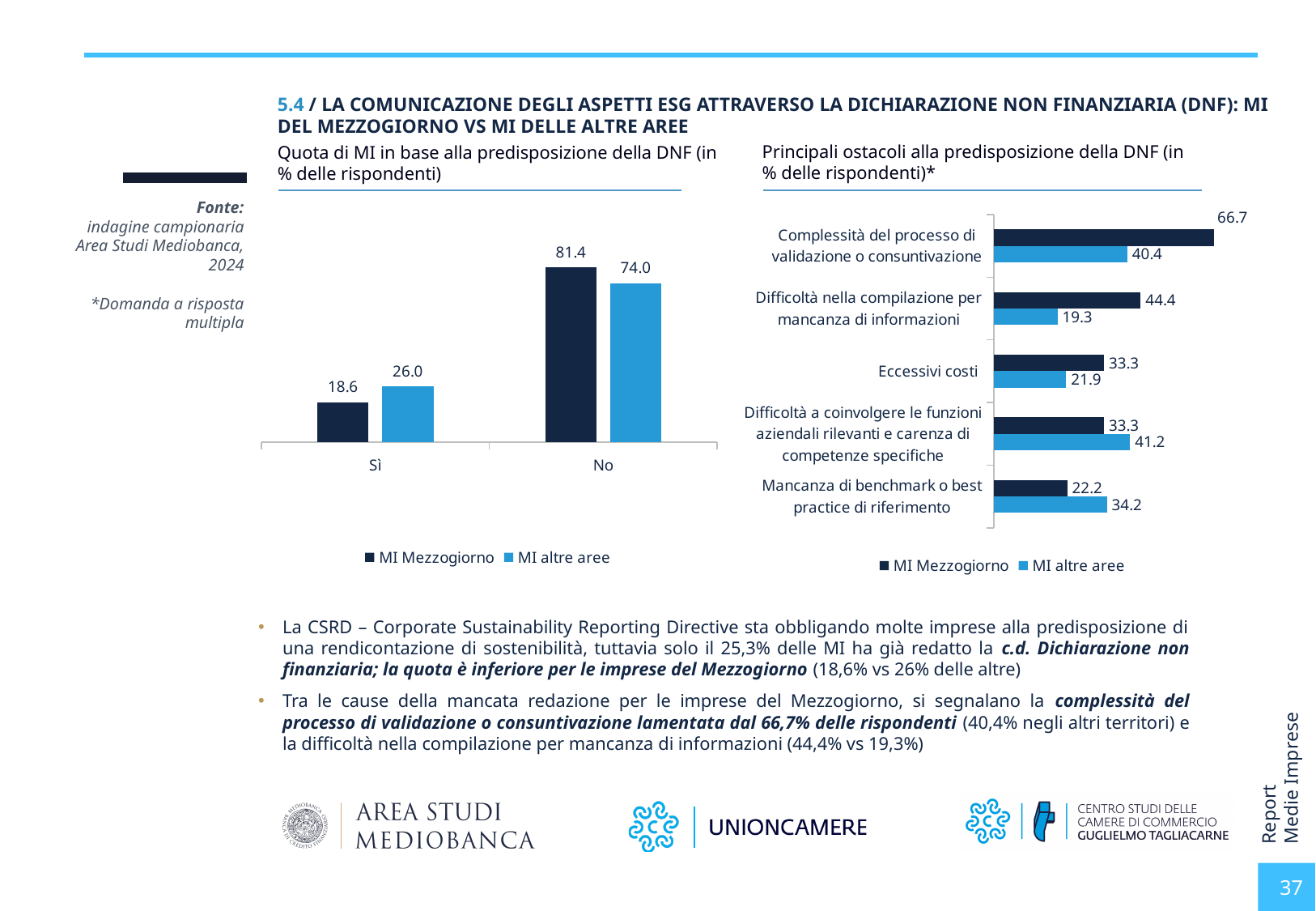
In the left chart (Quota di MI in base alla predisposizione della DNF), what is the value for MI altre aree in the 'No' category? 74.0 In the right chart (Principali ostacoli alla predisposizione della DNF), what is the value for MI Mezzogiorno for 'Complessità del processo di validazione o consuntivazione'? 66.7 In the right chart (Principali ostacoli alla predisposizione della DNF), which obstacle has the highest value for MI Mezzogiorno? Complessità del processo di validazione o consuntivazione In the right chart (Principali ostacoli alla predisposizione della DNF), which obstacle has the lowest value for MI altre aree? Difficoltà nella compilazione per mancanza di informazioni In the left chart (Quota di MI in base alla predisposizione della DNF), what is the value for MI Mezzogiorno in the 'Sì' category? 18.6 In the left chart (Quota di MI in base alla predisposizione della DNF), how many series does the legend list? 2 In the left chart (Quota di MI in base alla predisposizione della DNF), what kind of chart is shown? Bar chart In the right chart (Principali ostacoli alla predisposizione della DNF), for 'Mancanza di benchmark o best practice di riferimento', which series has the larger value, MI Mezzogiorno or MI altre aree? MI altre aree In the left chart (Quota di MI in base alla predisposizione della DNF), what is the difference between MI Mezzogiorno and MI altre aree in the 'No' category? 7.4 In the right chart (Principali ostacoli alla predisposizione della DNF), how many obstacle categories are shown? 5 In the right chart (Principali ostacoli alla predisposizione della DNF), what is the difference between MI Mezzogiorno and MI altre aree for 'Eccessivi costi'? 11.4 In the right chart (Principali ostacoli alla predisposizione della DNF), what is the value for MI altre aree for 'Difficoltà nella compilazione per mancanza di informazioni'? 19.3